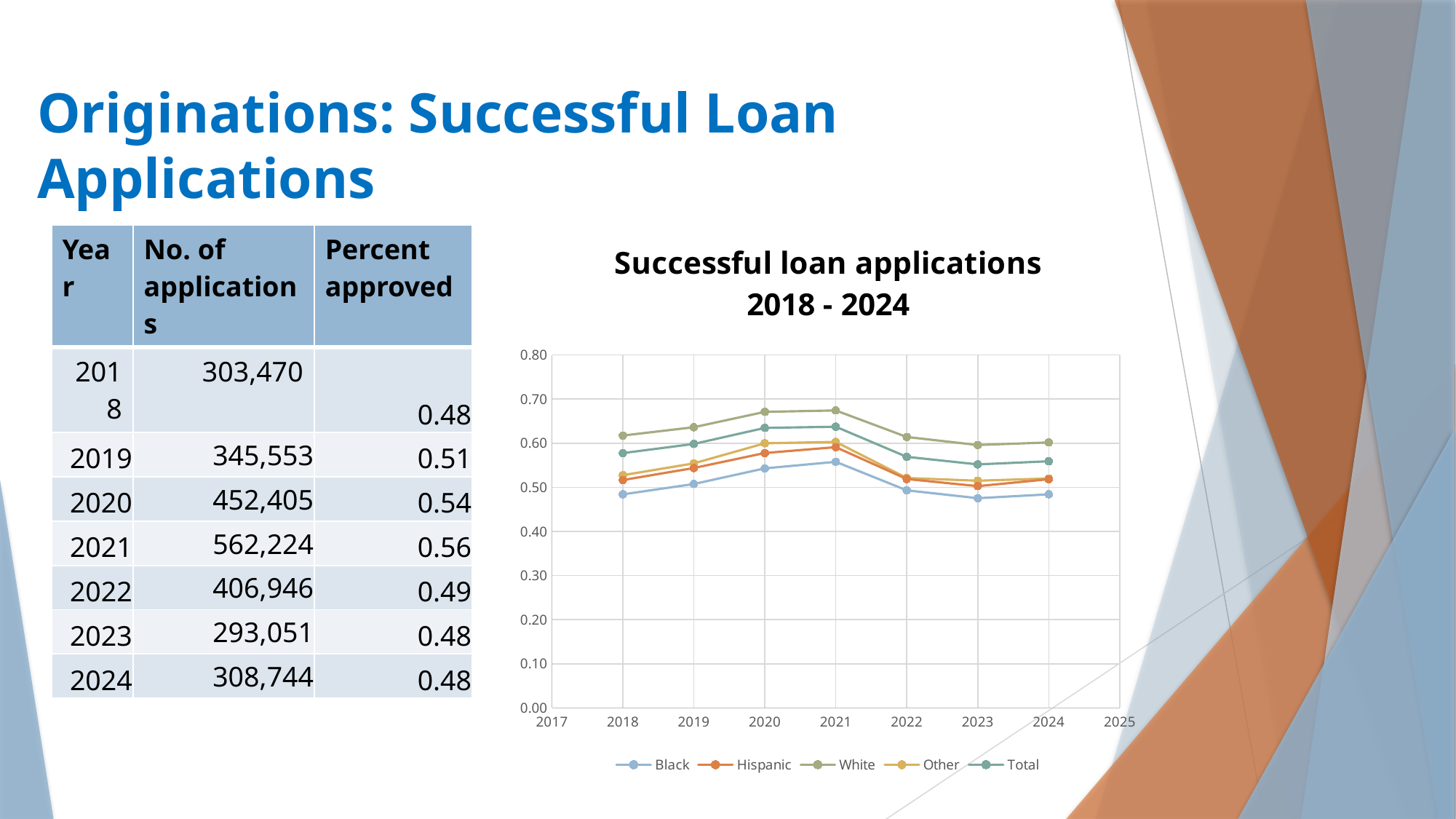
How many series does the chart legend list? 5 In 2022, which is larger, the value for Total or the value for Hispanic? Total In 2020, which is larger, the value for White or the value for Black? White Is the value for White in 2021 greater or less than 0.60? greater What is the title of the chart? Successful loan applications 2018 - 2024 Which series has the highest value in 2021? White Which series has the lowest value in 2021? Black What kind of chart is shown on the slide? line chart Does the Black series rise or fall from 2018 to 2021? rise Is the value for Black in 2023 greater or less than 0.50? less Is the value for Total in 2020 greater or less than 0.60? greater How many years have data points plotted on the chart? 7